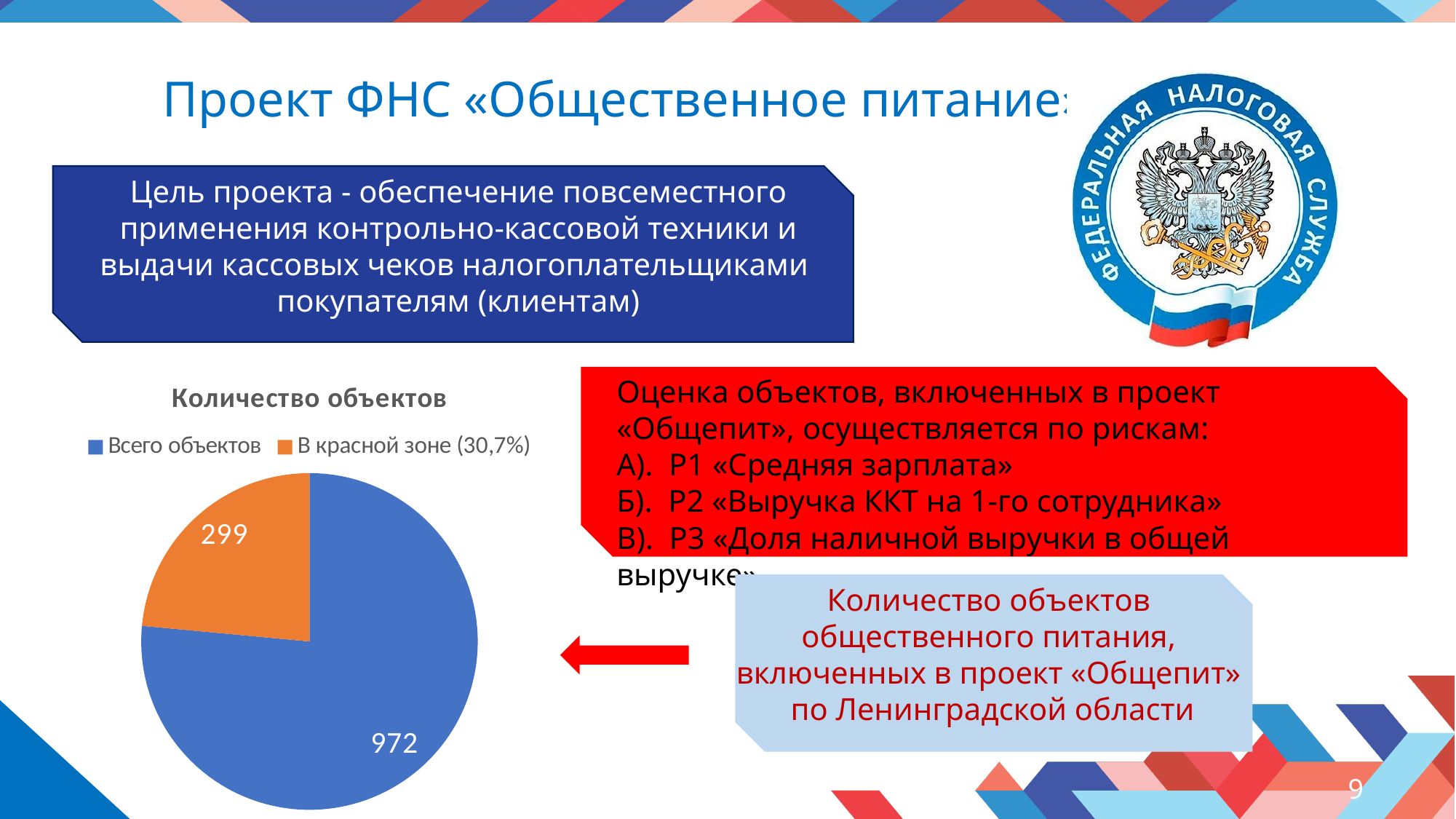
How many entries does the legend of the pie chart list? 2 How many slices does the pie chart have? 2 Which slice of the pie chart is the smallest? В красной зоне (30,7%) What is the title of the pie chart? Количество объектов Which is larger in the pie chart: "Всего объектов" or "В красной зоне (30,7%)"? Всего объектов What is the value of the "Всего объектов" slice in the pie chart? 972 Which slice of the pie chart is the largest? Всего объектов What colour is the "В красной зоне (30,7%)" slice in the pie chart? orange What is the value of the "В красной зоне (30,7%)" slice in the pie chart? 299 What is the difference between the "Всего объектов" value and the "В красной зоне (30,7%)" value in the pie chart? 673 What is the sum of the two values shown in the pie chart? 1271 What kind of chart is shown on the slide? pie chart